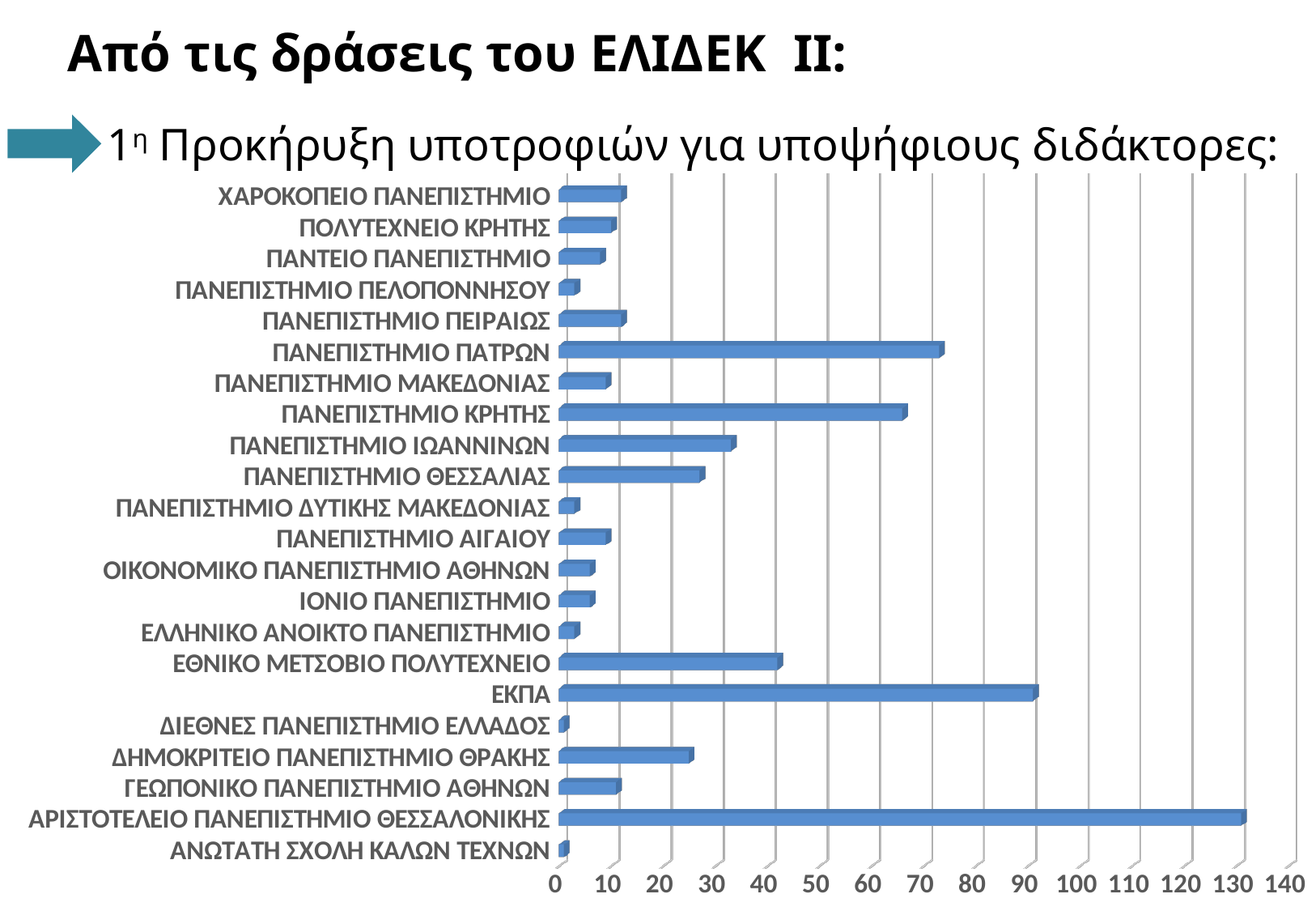
Which university has the highest value in the chart? ΑΡΙΣΤΟΤΕΛΕΙΟ ΠΑΝΕΠΙΣΤΗΜΙΟ ΘΕΣΣΑΛΟΝΙΚΗΣ How many universities (categories) are plotted in the chart? 22 Which has the larger value, ΠΑΝΕΠΙΣΤΗΜΙΟ ΙΩΑΝΝΙΝΩΝ or ΠΑΝΕΠΙΣΤΗΜΙΟ ΘΕΣΣΑΛΙΑΣ? ΠΑΝΕΠΙΣΤΗΜΙΟ ΙΩΑΝΝΙΝΩΝ Is the value for ΕΚΠΑ greater or less than 80? greater Is the value for ΠΑΝΕΠΙΣΤΗΜΙΟ ΙΩΑΝΝΙΝΩΝ greater or less than 20? greater Which has the larger value, ΠΑΝΕΠΙΣΤΗΜΙΟ ΠΑΤΡΩΝ or ΠΑΝΕΠΙΣΤΗΜΙΟ ΚΡΗΤΗΣ? ΠΑΝΕΠΙΣΤΗΜΙΟ ΠΑΤΡΩΝ Is the value for ΑΡΙΣΤΟΤΕΛΕΙΟ ΠΑΝΕΠΙΣΤΗΜΙΟ ΘΕΣΣΑΛΟΝΙΚΗΣ greater or less than 120? greater What kind of chart is shown on the slide? Bar chart Which has the larger value, ΕΚΠΑ or ΕΘΝΙΚΟ ΜΕΤΣΟΒΙΟ ΠΟΛΥΤΕΧΝΕΙΟ? ΕΚΠΑ What is the maximum value shown on the horizontal axis of the chart? 140